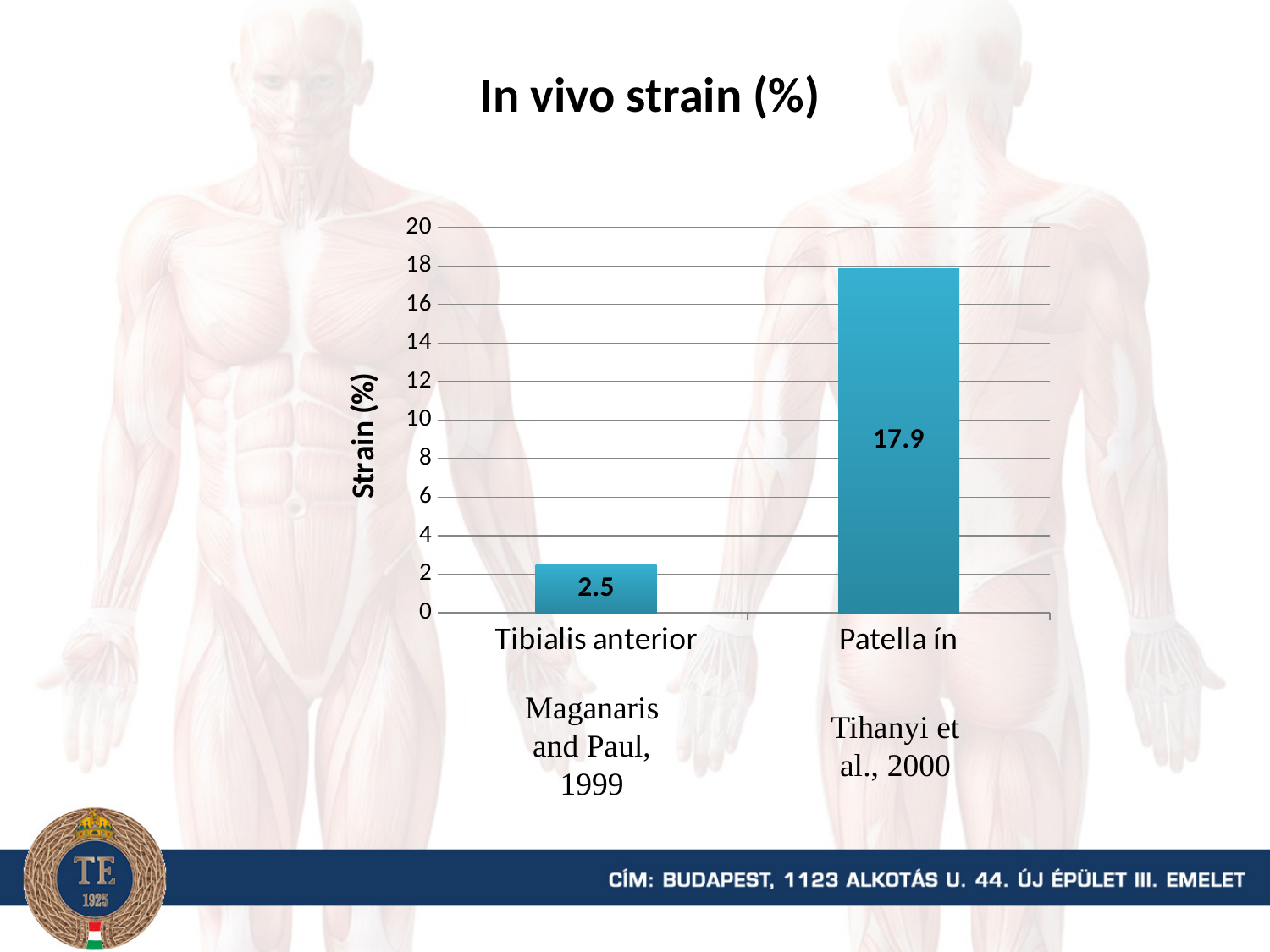
Which category has the highest strain value? Patella ín What kind of chart is shown on the slide? Bar chart Which category has the lowest strain value? Tibialis anterior What is the in vivo strain value for Patella ín? 17.9 How many categories are shown in the chart? 2 What is the title of the chart? In vivo strain (%) What is the label of the vertical axis? Strain (%) What is the difference between the strain values for Patella ín and Tibialis anterior? 15.4 Which has a larger strain value, Tibialis anterior or Patella ín? Patella ín What is the in vivo strain value for Tibialis anterior? 2.5 Is the strain value for Patella ín greater or less than 16? greater Is the strain value for Tibialis anterior greater or less than 4? less